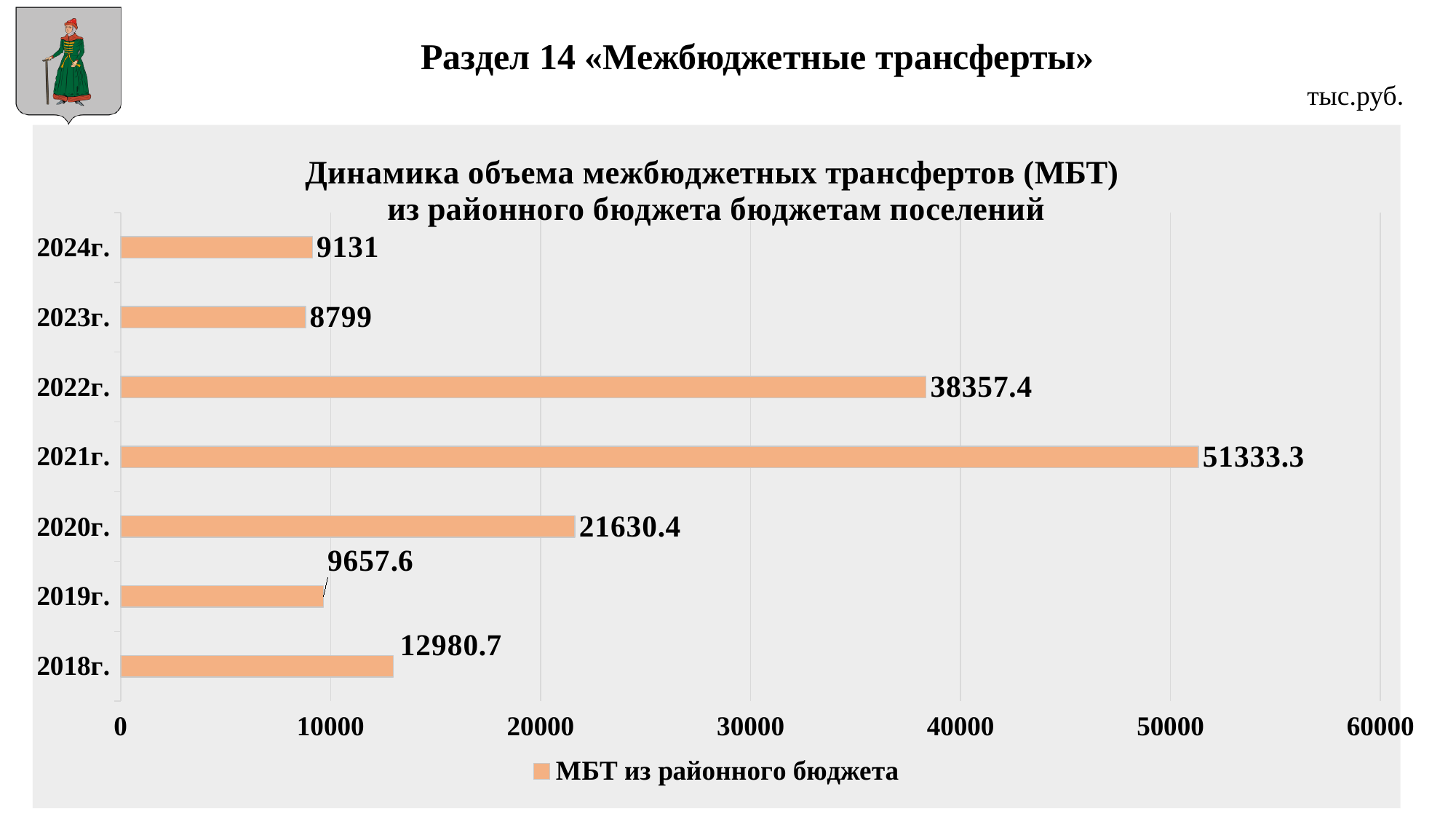
What is the difference between the values for 2021г. and 2022г.? 12975.9 Which year has the highest value? 2021г. What is the legend entry for the series shown? МБТ из районного бюджета What kind of chart is shown on the slide? bar chart Is the value for 2022г. greater or less than 40000? less Which year has the lowest value? 2023г. Which is larger, the value for 2020г. or the value for 2018г.? 2020г. What is the value for 2018г.? 12980.7 What is the difference between the values for 2024г. and 2023г.? 332 How many years are shown on the chart? 7 What is the value for 2021г.? 51333.3 What is the value for 2023г.? 8799